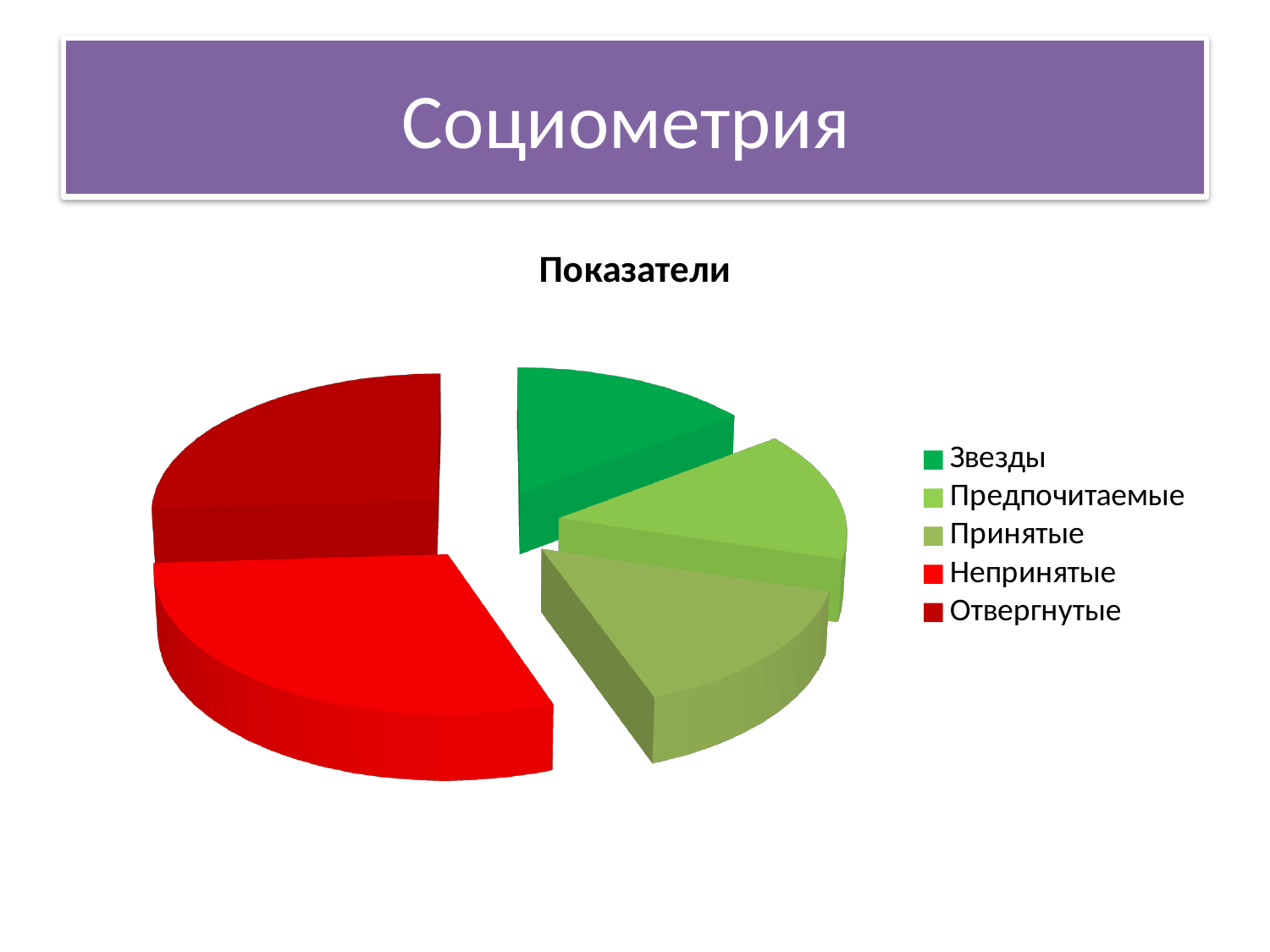
Which slice is larger, Отвергнутые or Звезды? Отвергнутые How many entries does the legend list? 5 Which slice is larger, Непринятые or Отвергнутые? Непринятые What is the title of the chart? Показатели Which category has the largest slice of the pie? Непринятые How many slices does the pie chart have? 5 Which slice is larger, Непринятые or Принятые? Непринятые Which legend entry is shown in bright red? Непринятые What kind of chart is shown on the slide? pie chart